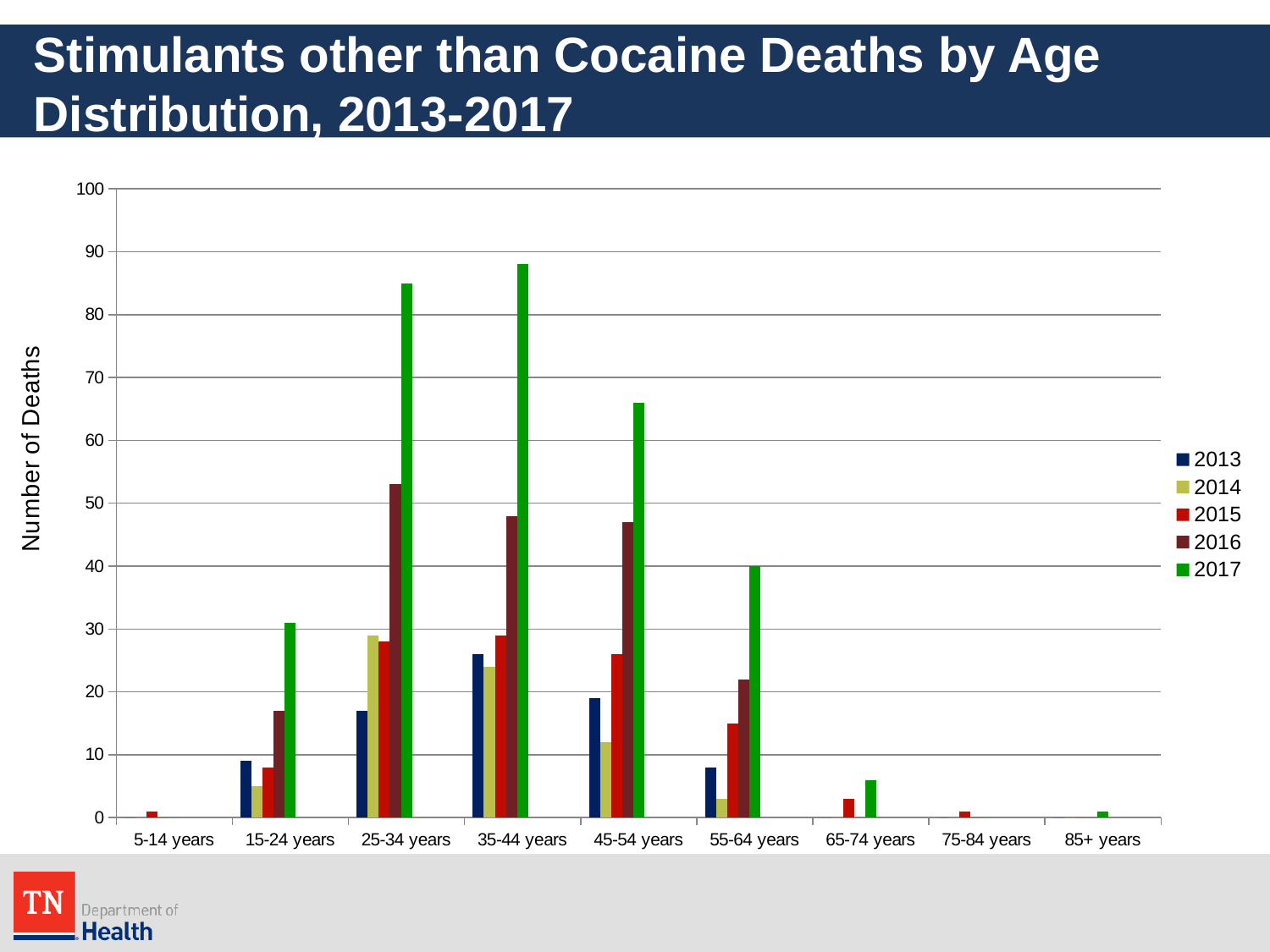
Is the value for 2017 in the 45-54 years group greater or less than 60? greater Is the value for 2017 in the 25-34 years group greater or less than 80? greater How many age groups are shown on the x axis? 9 What kind of chart is shown on the slide? Bar chart What is the title of the vertical axis? Number of Deaths In the 15-24 years group, which is larger: the value for 2013 or the value for 2014? 2013 How many series does the legend list? 5 Is the value for 2013 in the 35-44 years group greater or less than 20? greater Which age group has the highest number of deaths for 2016? 25-34 years In the 45-54 years group, which is larger: the value for 2016 or the value for 2017? 2017 Which age group has the highest number of deaths for 2013? 35-44 years